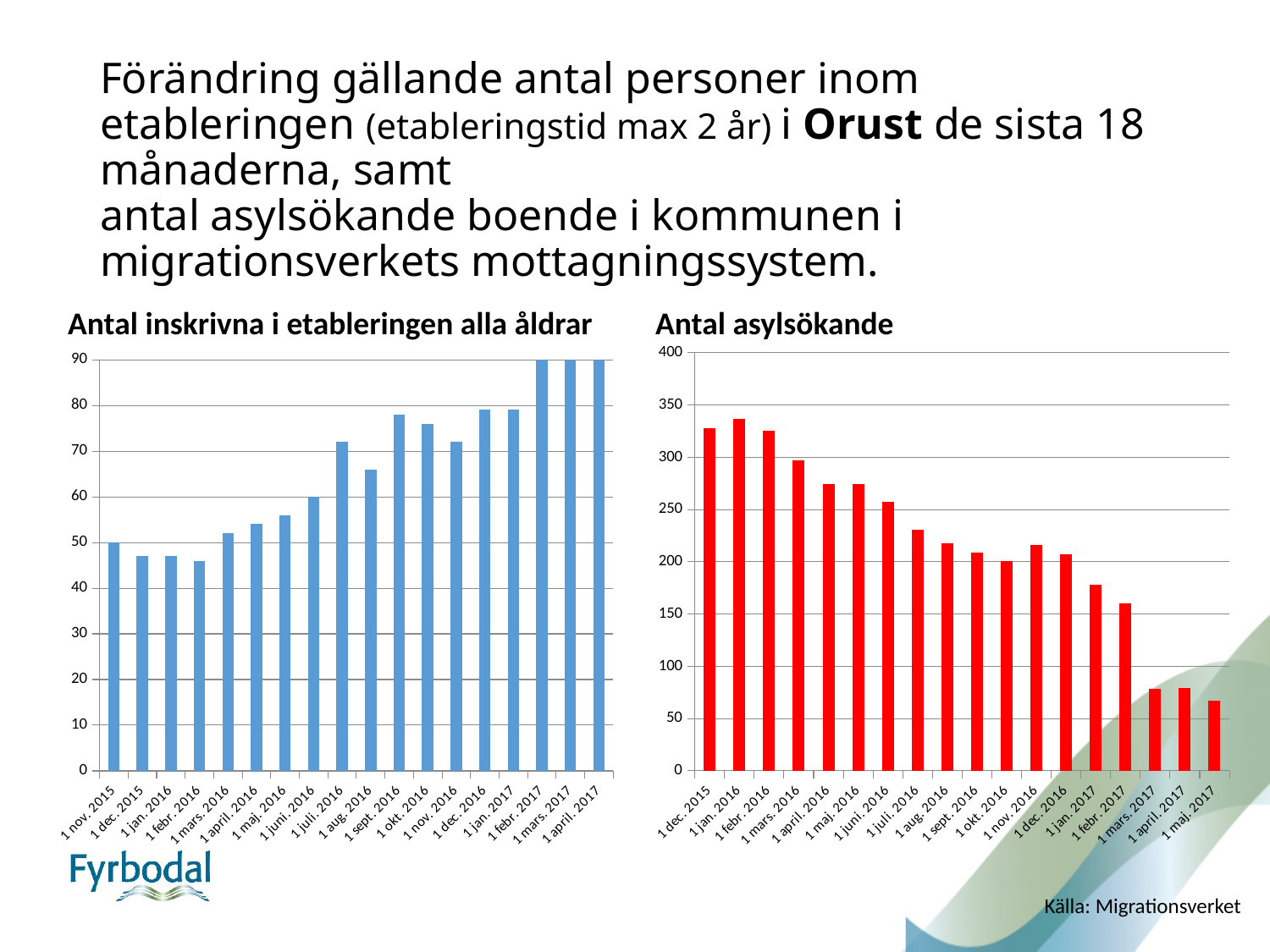
How many bars (months) are shown in the left chart, 'Antal inskrivna i etableringen alla åldrar'? 18 In the left chart, 'Antal inskrivna i etableringen alla åldrar', is the value for 1 mars 2016 greater or less than 60? less In the left chart, 'Antal inskrivna i etableringen alla åldrar', which is larger: the value for 1 aug. 2016 or 1 sept. 2016? 1 sept. 2016 What kind of chart is the left chart, 'Antal inskrivna i etableringen alla åldrar'? bar chart In the right chart, 'Antal asylsökande', which month has the lowest value? 1 maj 2017 In the left chart, 'Antal inskrivna i etableringen alla åldrar', is the value for 1 sept. 2016 greater or less than 70? greater In the right chart, 'Antal asylsökande', is the value for 1 mars 2017 greater or less than 100? less What colour are the bars in the right chart, 'Antal asylsökande'? red How many bars (months) are shown in the right chart, 'Antal asylsökande'? 18 In the left chart, 'Antal inskrivna i etableringen alla åldrar', do the values generally rise or fall from 1 nov. 2015 to 1 april 2017? rise In the right chart, 'Antal asylsökande', do the values generally rise or fall from 1 dec. 2015 to 1 maj 2017? fall